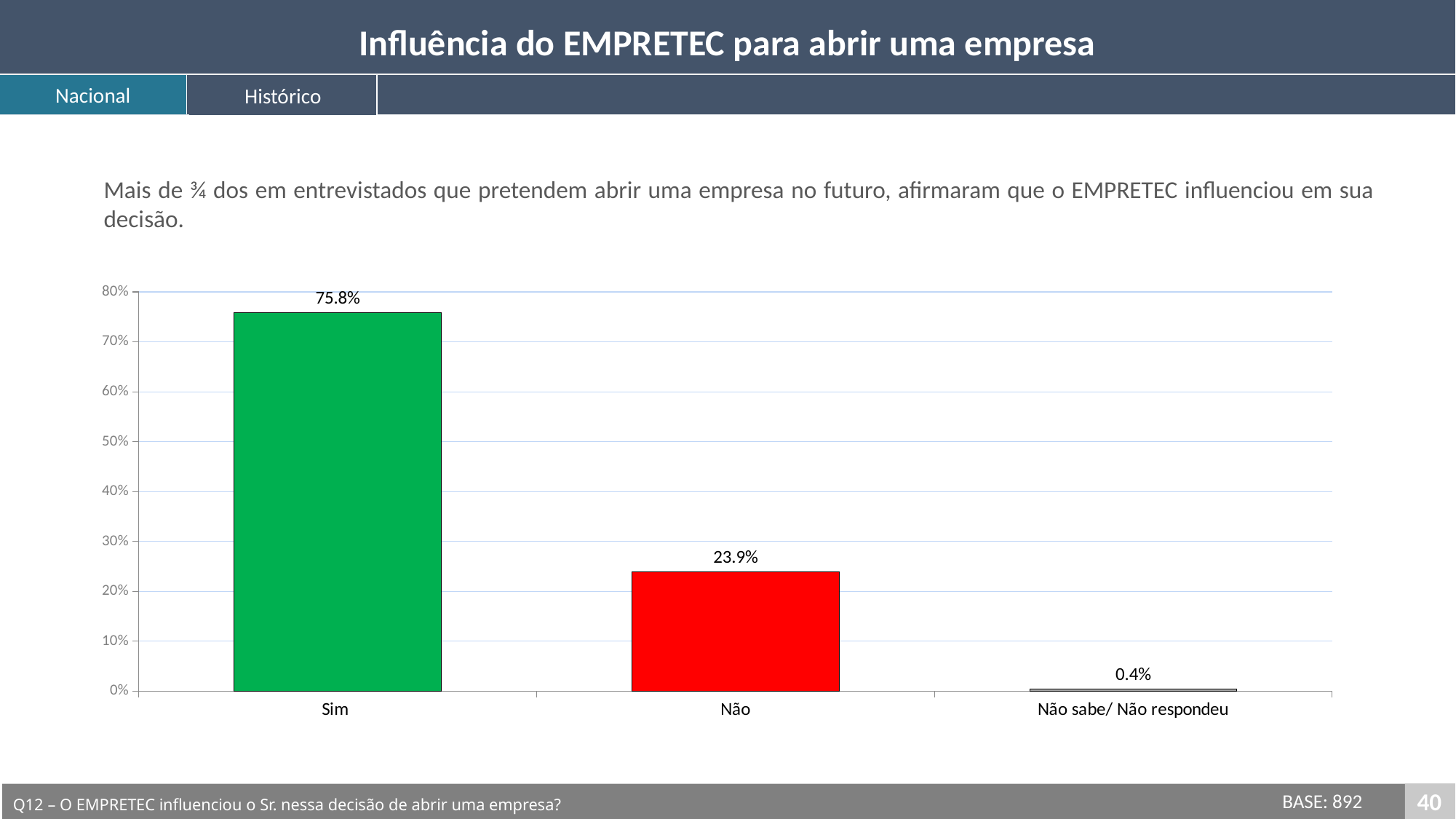
What is the title of the slide? Influência do EMPRETEC para abrir uma empresa Which category has the lowest value? Não sabe/ Não respondeu What is the value for Sim? 75.8% What is the value for Não sabe/ Não respondeu? 0.4% What is the value for Não? 23.9% Which category has the highest value? Sim What kind of chart is shown on the slide? bar chart What colour is the bar for Sim? green Which is larger, the value for Não or the value for Não sabe/ Não respondeu? Não Is the value for Não greater or less than 30%? less What is the difference between the values for Sim and Não? 51.9% How many categories are shown on the x axis? 3